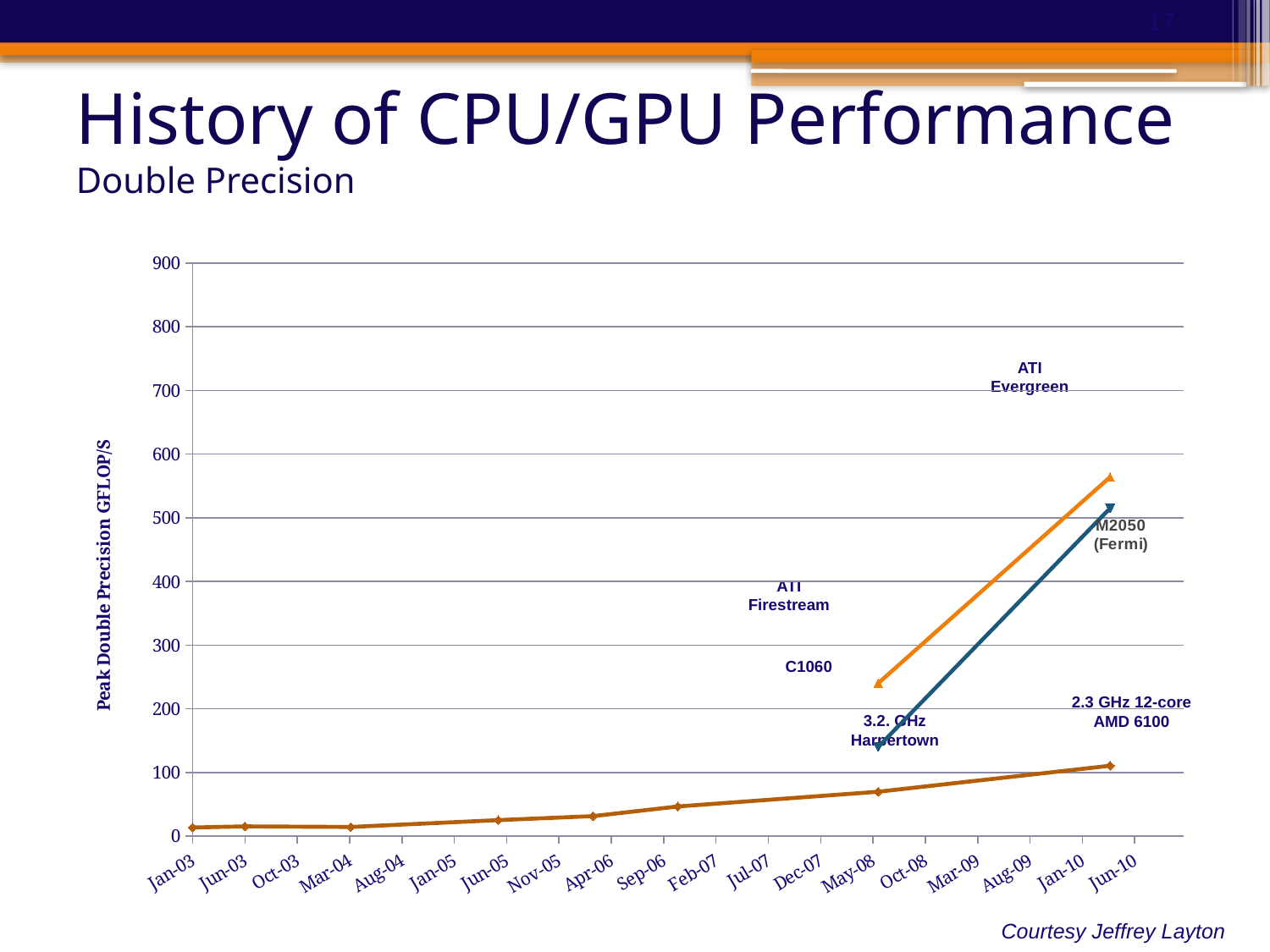
Is the value for M2050 (Fermi) greater or less than 400? greater What is the highest value shown on the vertical axis? 900 Which labelled point has the highest peak double precision performance? ATI Evergreen What kind of chart is shown on the slide? line chart Does the CPU line rise or fall from Jan-03 to Jun-10? rise Which is higher, the value for ATI Evergreen or the value for M2050 (Fermi)? ATI Evergreen Is the value for ATI Firestream greater or less than 200? greater What is the title of the vertical axis? Peak Double Precision GFLOP/S Is the value for 2.3 GHz 12-core AMD 6100 greater or less than 200? less